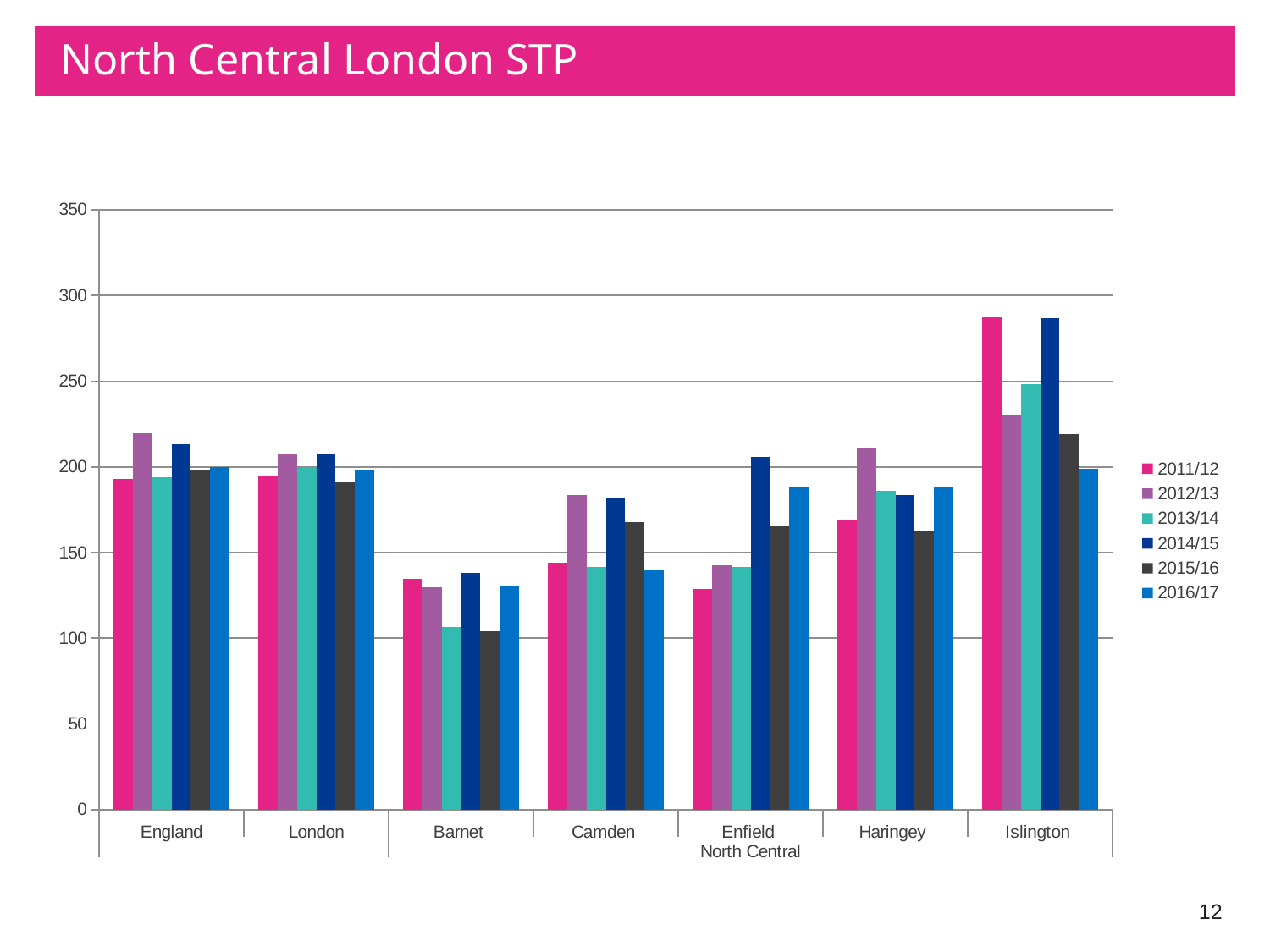
Is the 2011/12 value for Islington greater or less than 250? greater Which has the larger 2012/13 value: Camden or Barnet? Camden Is the 2013/14 value for Barnet greater or less than 150? less Is the 2012/13 value for Haringey greater or less than 200? greater How many categories are shown along the x axis of the chart? 7 Which category has the lowest value for the 2014/15 series? Barnet For Enfield, which series has the larger value: 2014/15 or 2011/12? 2014/15 How many series does the chart's legend list? 6 What kind of chart is shown on the slide? bar chart Which category has the highest value for the 2011/12 series? Islington What is the first entry listed in the chart's legend? 2011/12 Which category has the lowest value for the 2015/16 series? Barnet